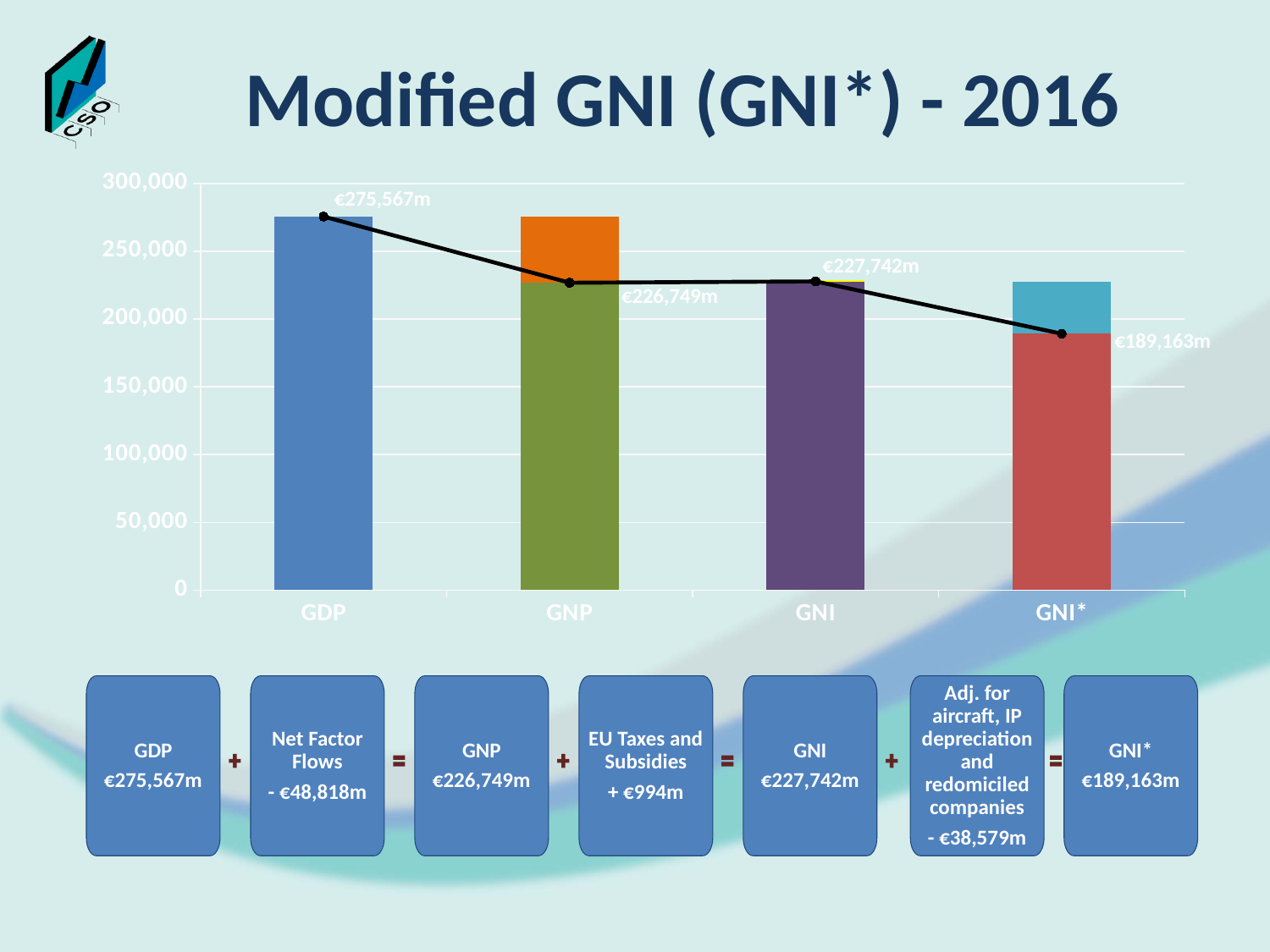
Which is larger, the labelled value for GDP or for GNI*? GDP What is the value labelled for GNI in the chart? €227,742m What is the difference between the labelled values for GDP and GNP? €48,818m Which category has the highest labelled value in the chart? GDP What is the title of the slide containing the chart? Modified GNI (GNI*) - 2016 Is the labelled value for GNI* greater or less than 200,000? less How many categories are shown on the x axis of the chart? 4 What is the value labelled for GNI* in the chart? €189,163m Which category has the lowest labelled value in the chart? GNI* What is the difference between the labelled values for GNI and GNI*? €38,579m What is the value labelled for GNP in the chart? €226,749m What is the value labelled for GDP in the chart? €275,567m